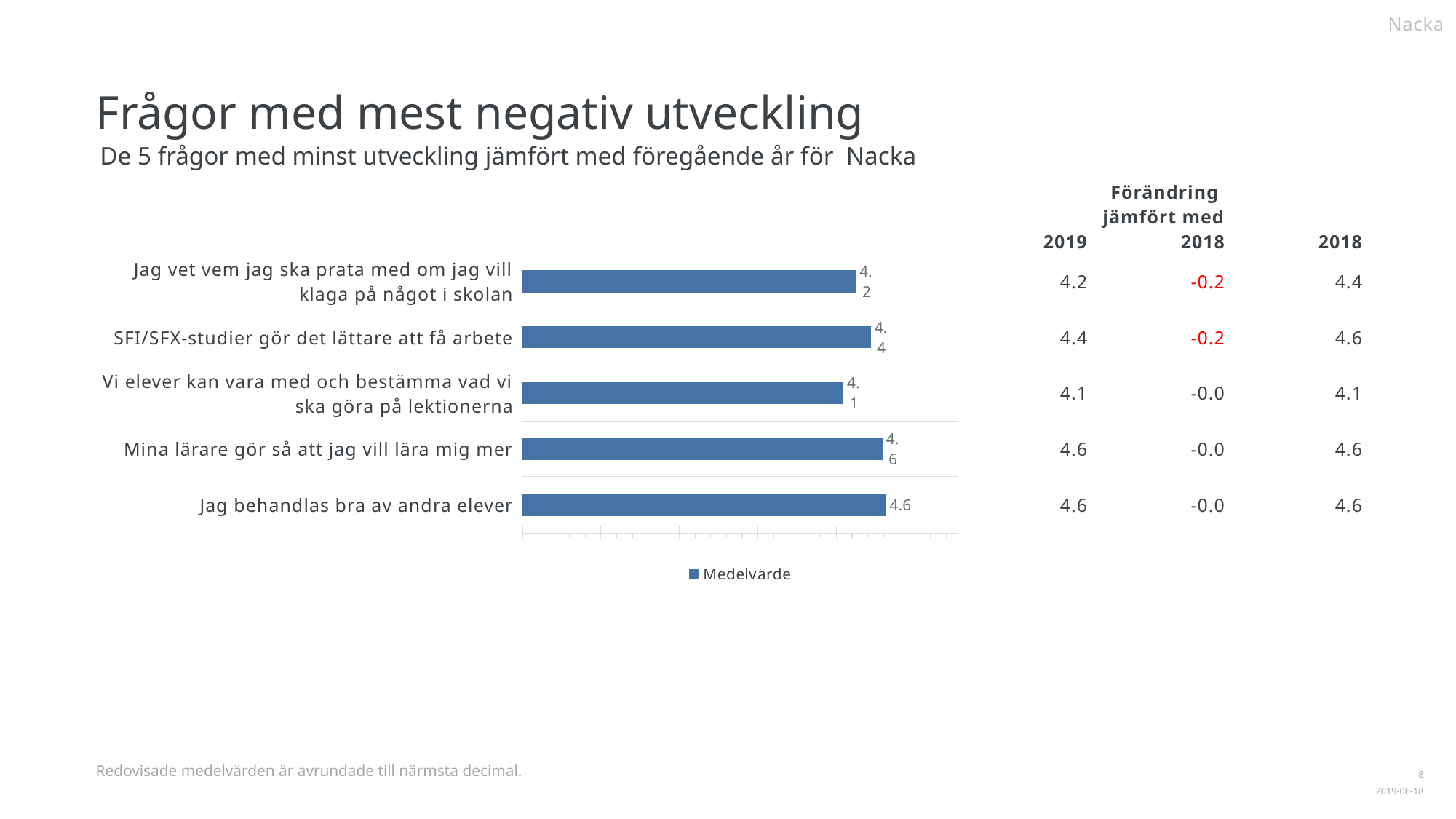
How many series does the chart legend list? 1 Which has a higher Medelvärde: "SFI/SFX-studier gör det lättare att få arbete" or "Jag vet vem jag ska prata med om jag vill klaga på något i skolan"? SFI/SFX-studier gör det lättare att få arbete Which question has the lowest Medelvärde in the chart? Vi elever kan vara med och bestämma vad vi ska göra på lektionerna What is the Medelvärde value for "Jag behandlas bra av andra elever"? 4.6 What kind of chart is shown on the slide? Bar chart What is the difference between the Medelvärde for "SFI/SFX-studier gör det lättare att få arbete" and "Jag vet vem jag ska prata med om jag vill klaga på något i skolan"? 0.2 What is the Medelvärde value for "Jag vet vem jag ska prata med om jag vill klaga på något i skolan"? 4.2 What is the Medelvärde value for "Vi elever kan vara med och bestämma vad vi ska göra på lektionerna"? 4.1 What is the difference between the Medelvärde for "Mina lärare gör så att jag vill lära mig mer" and "Vi elever kan vara med och bestämma vad vi ska göra på lektionerna"? 0.5 How many questions (categories) are shown in the bar chart? 5 What is the name of the series shown in the chart legend? Medelvärde What is the Medelvärde value for "SFI/SFX-studier gör det lättare att få arbete"? 4.4